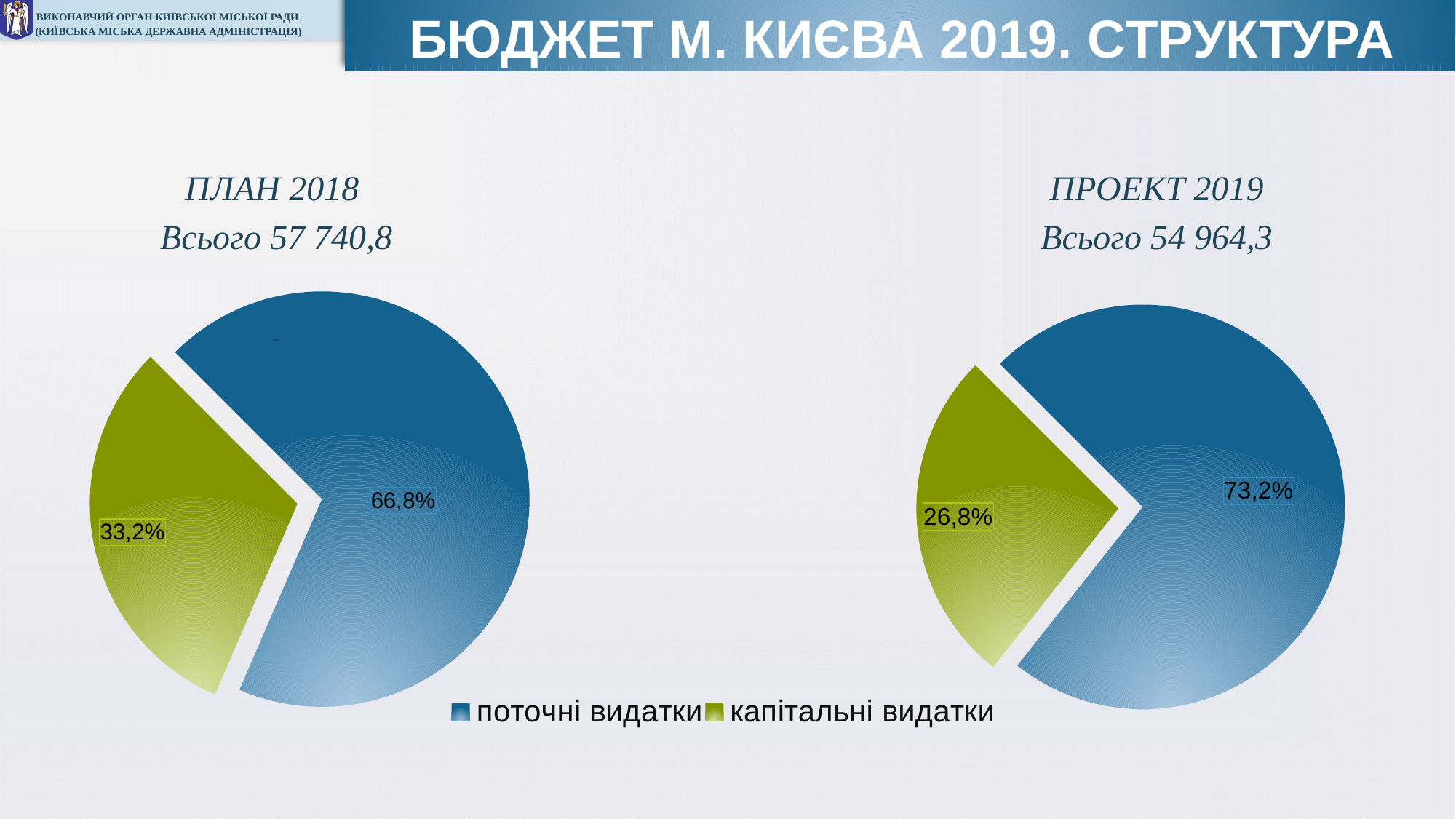
In the ПЛАН 2018 pie chart, what is the difference in percentage points between поточні видатки and капітальні видатки? 33,6 What kind of chart is used on this slide? Pie chart In the ПЛАН 2018 pie chart, what share is labelled for капітальні видатки? 33,2% In the ПРОЕКТ 2019 pie chart, what share is labelled for поточні видатки? 73,2% How many slices does the ПРОЕКТ 2019 pie chart have? 2 Which is larger: the share of капітальні видатки in ПЛАН 2018 or in ПРОЕКТ 2019? ПЛАН 2018 In the ПРОЕКТ 2019 pie chart, which category has the largest slice? поточні видатки In the ПЛАН 2018 pie chart, which category has the smallest slice? капітальні видатки In the ПРОЕКТ 2019 pie chart, what share is labelled for капітальні видатки? 26,8% In the ПЛАН 2018 pie chart, what share is labelled for поточні видатки? 66,8% How many entries does the legend list? 2 What total (Всього) is shown above the ПРОЕКТ 2019 pie chart? 54 964,3